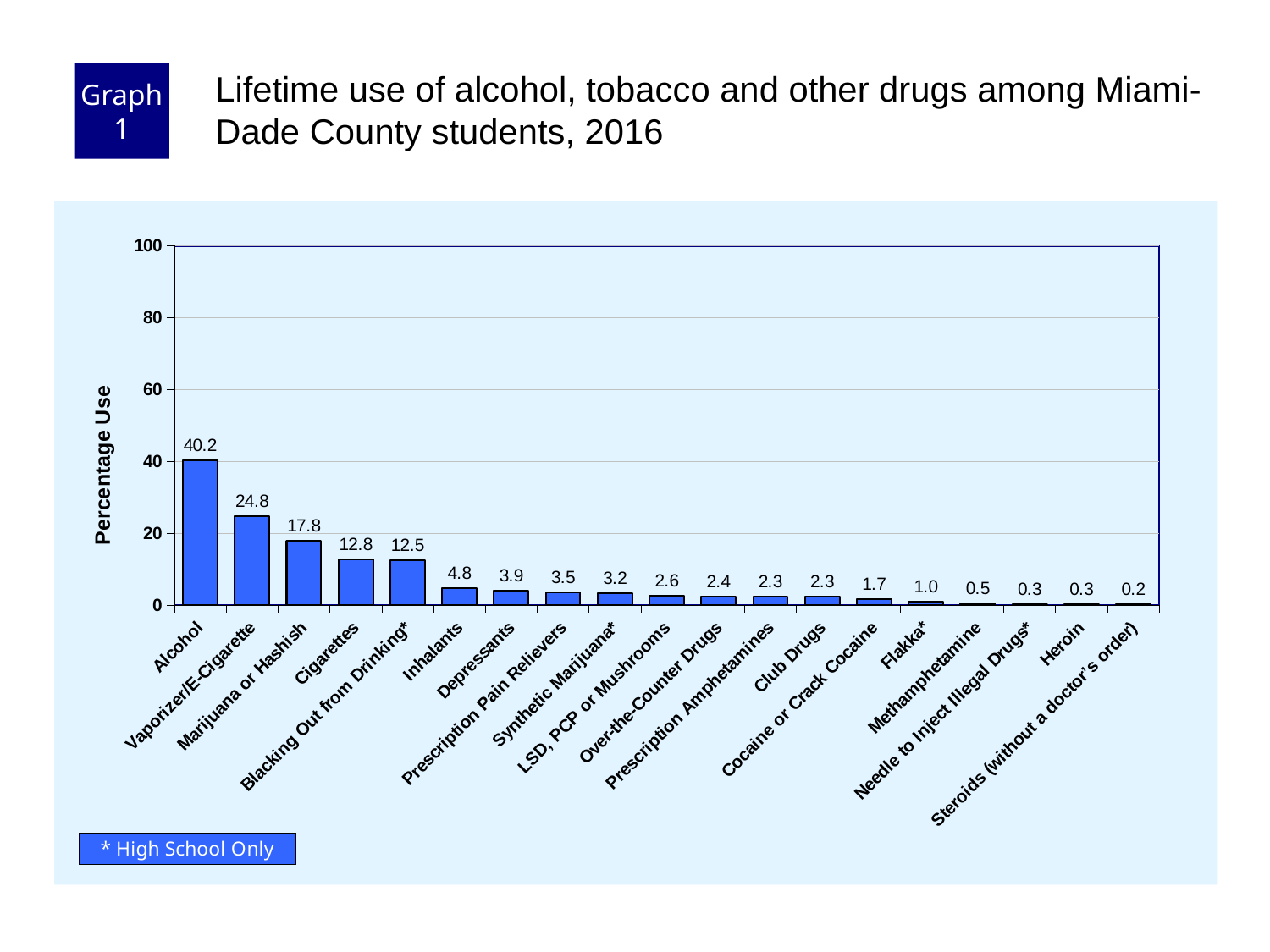
What is the label of the y axis? Percentage Use Which category has the highest percentage use? Alcohol What is the percentage use for Flakka*? 1.0 What kind of chart is shown on the slide? Bar chart What is the percentage use for Vaporizer/E-Cigarette? 24.8 What is the difference in percentage use between Alcohol and Vaporizer/E-Cigarette? 15.4 What is the difference in percentage use between Cigarettes and Blacking Out from Drinking*? 0.3 How many categories are shown on the chart? 19 What is the percentage use for Inhalants? 4.8 Which category has the lowest percentage use? Steroids (without a doctor's order) What is the percentage use for Alcohol? 40.2 Which has a higher percentage use, Marijuana or Hashish or Cigarettes? Marijuana or Hashish